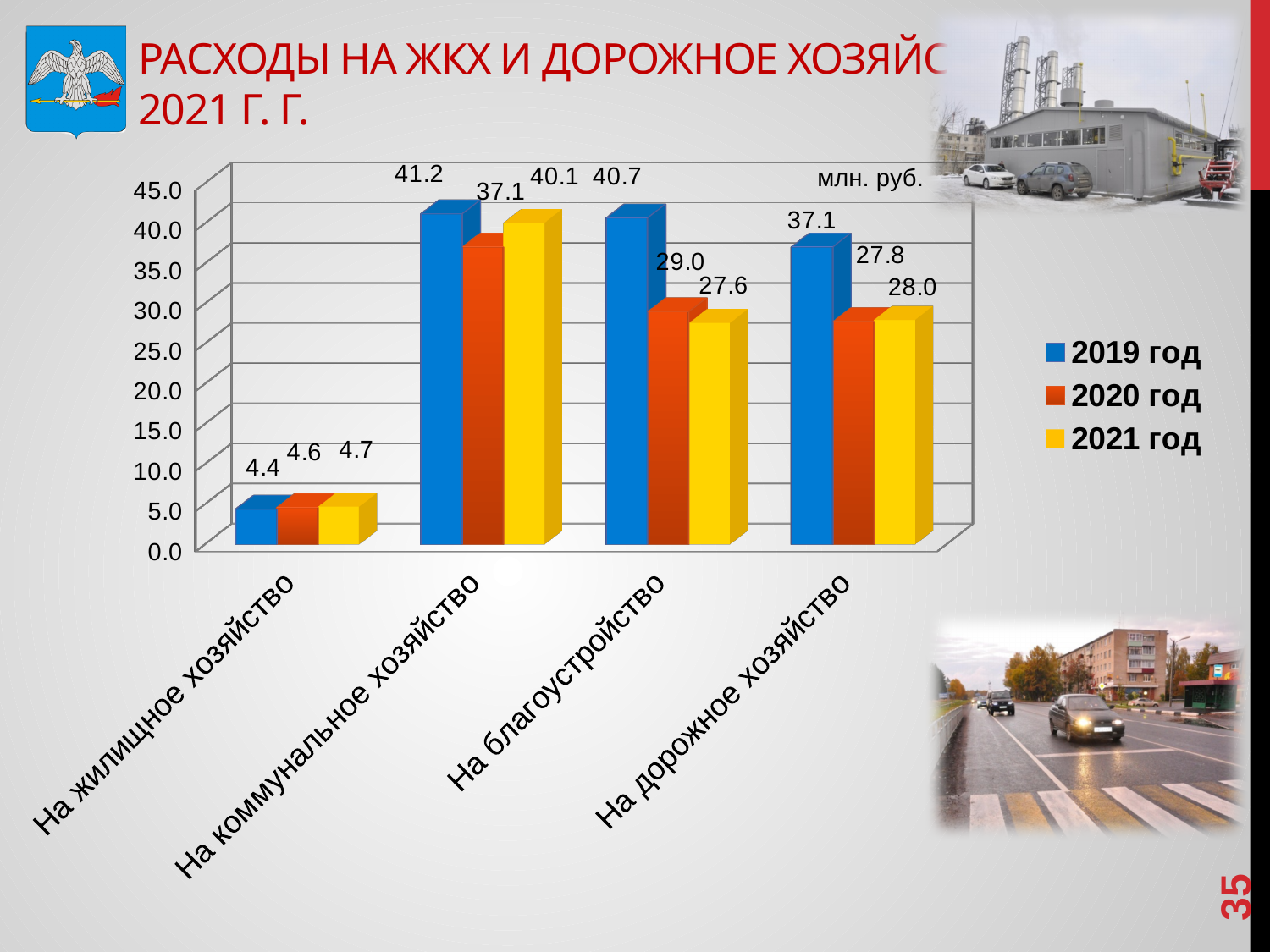
How many series does the legend list? 3 What is the value for На дорожное хозяйство in the 2019 год series? 37.1 What unit is indicated for the values on the chart? млн. руб. What is the difference between the 2019 год and 2020 год values for На благоустройство? 11.7 What kind of chart is shown on the slide? Bar chart What is the value for На жилищное хозяйство in the 2019 год series? 4.4 What is the value for На коммунальное хозяйство in the 2021 год series? 40.1 Which is larger for На дорожное хозяйство: the 2020 год value or the 2021 год value? 2021 год Which category has the highest value in the 2019 год series? На коммунальное хозяйство What is the value for На благоустройство in the 2020 год series? 29.0 How many categories are shown on the x axis? 4 Which category has the lowest value in the 2021 год series? На жилищное хозяйство